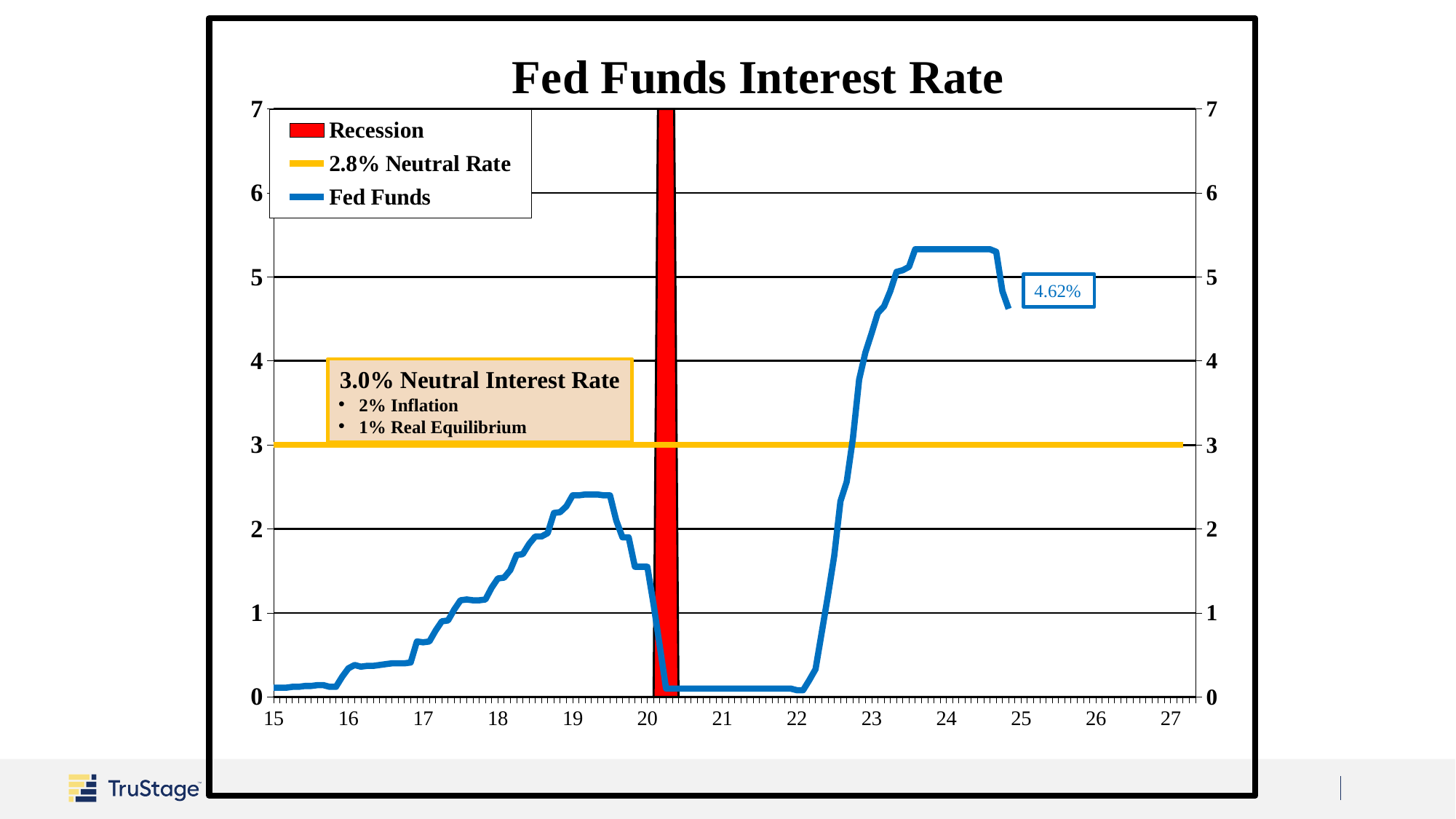
What kind of chart is shown on the slide? line chart Does the Fed Funds line rise or fall between 19 and 20? fall What does the red shaded area on the chart represent, according to the legend? Recession Is the Fed Funds value at 19 greater or less than 3? less Is the Fed Funds value at 24 greater or less than 5? greater Does the Fed Funds line rise or fall between 22 and 23? rise Is the Fed Funds value at 21 greater or less than 1? less How many entries does the chart's legend list? 3 Which is larger, the Fed Funds value at 24 or at 19? 24 What is the title of the chart? Fed Funds Interest Rate What is the labeled value at the end of the Fed Funds line? 4.62%